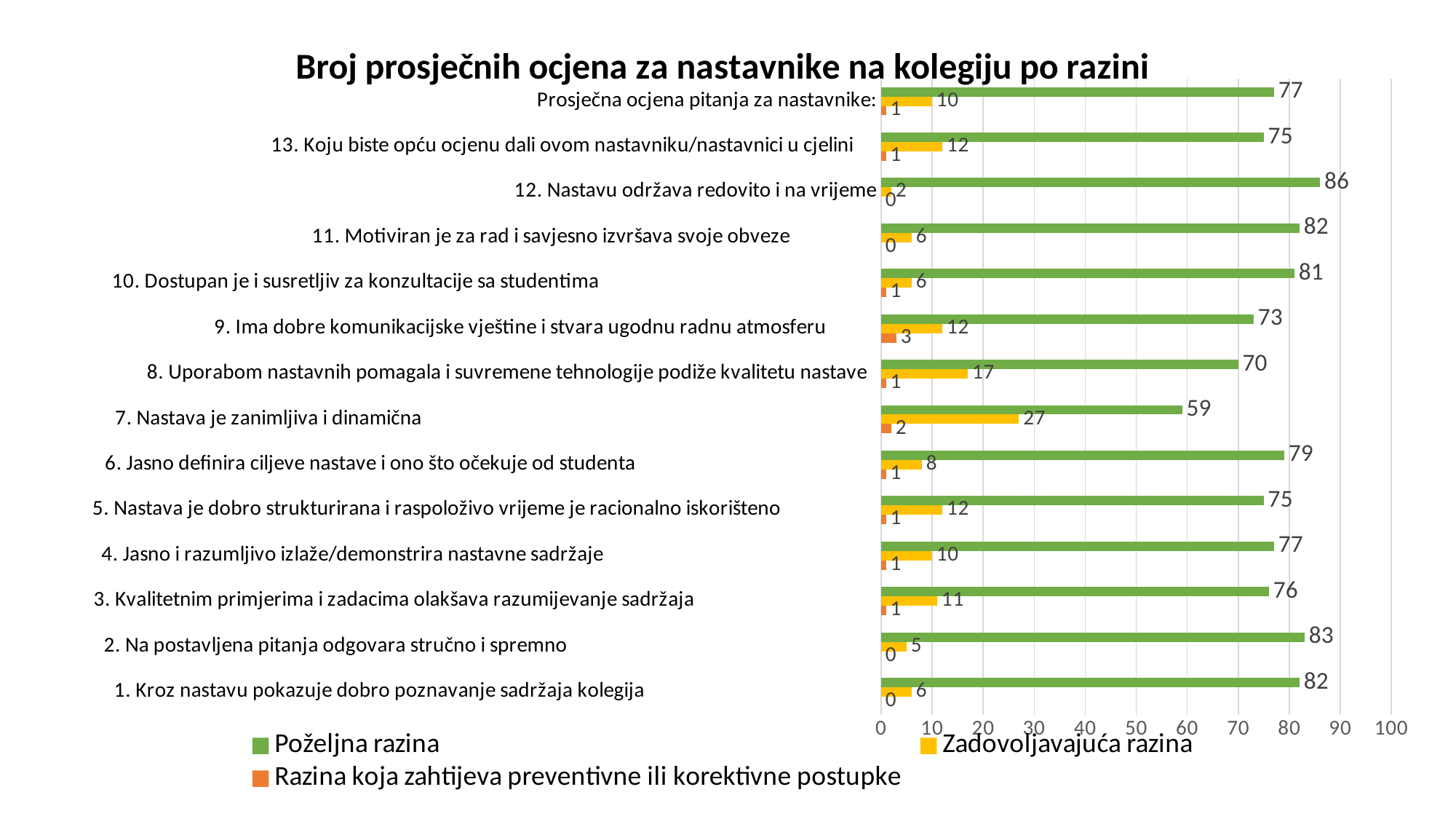
Which category has the highest Poželjna razina value? 12. Nastavu održava redovito i na vrijeme What is the total of the three values for "Prosječna ocjena pitanja za nastavnike:"? 88 How many categories are shown on the chart? 14 What is the value of Zadovoljavajuća razina for "7. Nastava je zanimljiva i dinamična"? 27 What is the value of Poželjna razina for "12. Nastavu održava redovito i na vrijeme"? 86 What is the title of the chart? Broj prosječnih ocjena za nastavnike na kolegiju po razini What kind of chart is shown on the slide? Bar chart How many series does the legend list? 3 Which has a larger Zadovoljavajuća razina value: "8. Uporabom nastavnih pomagala i suvremene tehnologije podiže kvalitetu nastave" or "6. Jasno definira ciljeve nastave i ono što očekuje od studenta"? 8. Uporabom nastavnih pomagala i suvremene tehnologije podiže kvalitetu nastave What is the difference between the Poželjna razina values for "2. Na postavljena pitanja odgovara stručno i spremno" and "8. Uporabom nastavnih pomagala i suvremene tehnologije podiže kvalitetu nastave"? 13 Which category has the lowest Poželjna razina value? 7. Nastava je zanimljiva i dinamična What is the value of Razina koja zahtijeva preventivne ili korektivne postupke for "9. Ima dobre komunikacijske vještine i stvara ugodnu radnu atmosferu"? 3